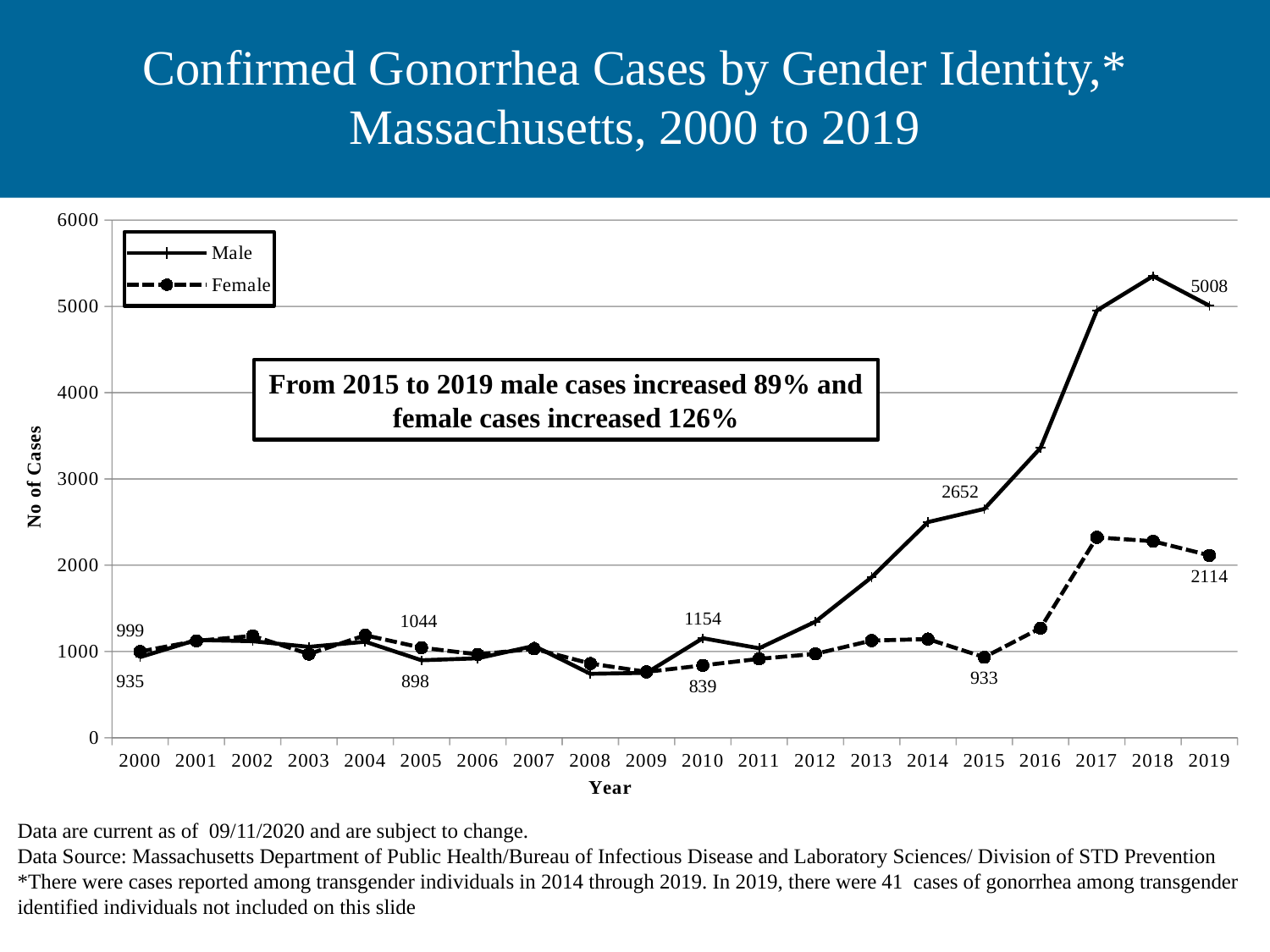
Is the value for male cases in 2017 greater or less than 4000? greater In which year did male cases reach their highest value? 2018 What kind of chart is shown on the slide? Line chart How many years are plotted along the x axis? 20 What is the difference between male and female cases in 2019? 2894 In 2005, which series had more cases, Male or Female? Female What is the number of male cases in 2019? 5008 What is the number of female cases in 2000? 999 What is the difference between male and female cases in 2010? 315 What is the number of male cases in 2015? 2652 How many series does the legend list? 2 What is the number of female cases in 2019? 2114